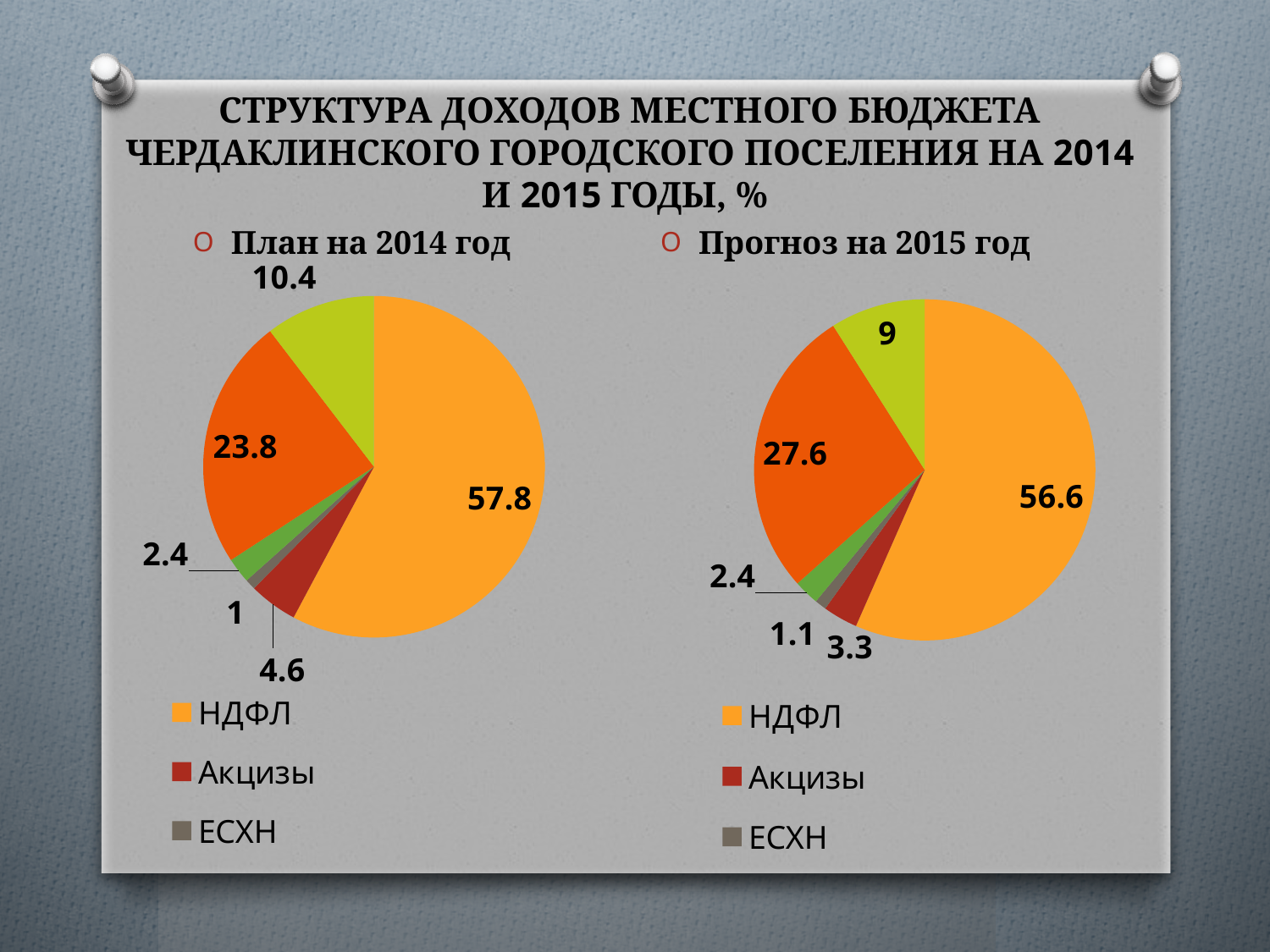
In the 'Прогноз на 2015 год' pie chart, what is the value for НДФЛ? 56.6 What type of chart is used on this slide? Pie chart How many slices does the 'План на 2014 год' pie chart have? 6 In the 'План на 2014 год' pie chart, which category has the largest slice? НДФЛ In the 'Прогноз на 2015 год' pie chart, which category has the largest slice? НДФЛ In the 'План на 2014 год' pie chart, what is the value for ЕСХН? 1 In the 'Прогноз на 2015 год' pie chart, what is the value for Акцизы? 3.3 In the 'Прогноз на 2015 год' pie chart, what is the value for ЕСХН? 1.1 In the 'План на 2014 год' pie chart, what is the value for Акцизы? 4.6 Is the Акцизы value larger in the 'План на 2014 год' chart or in the 'Прогноз на 2015 год' chart? План на 2014 год In the 'План на 2014 год' pie chart, what is the value for НДФЛ? 57.8 What is the difference between the НДФЛ value in the 'План на 2014 год' chart and the НДФЛ value in the 'Прогноз на 2015 год' chart? 1.2